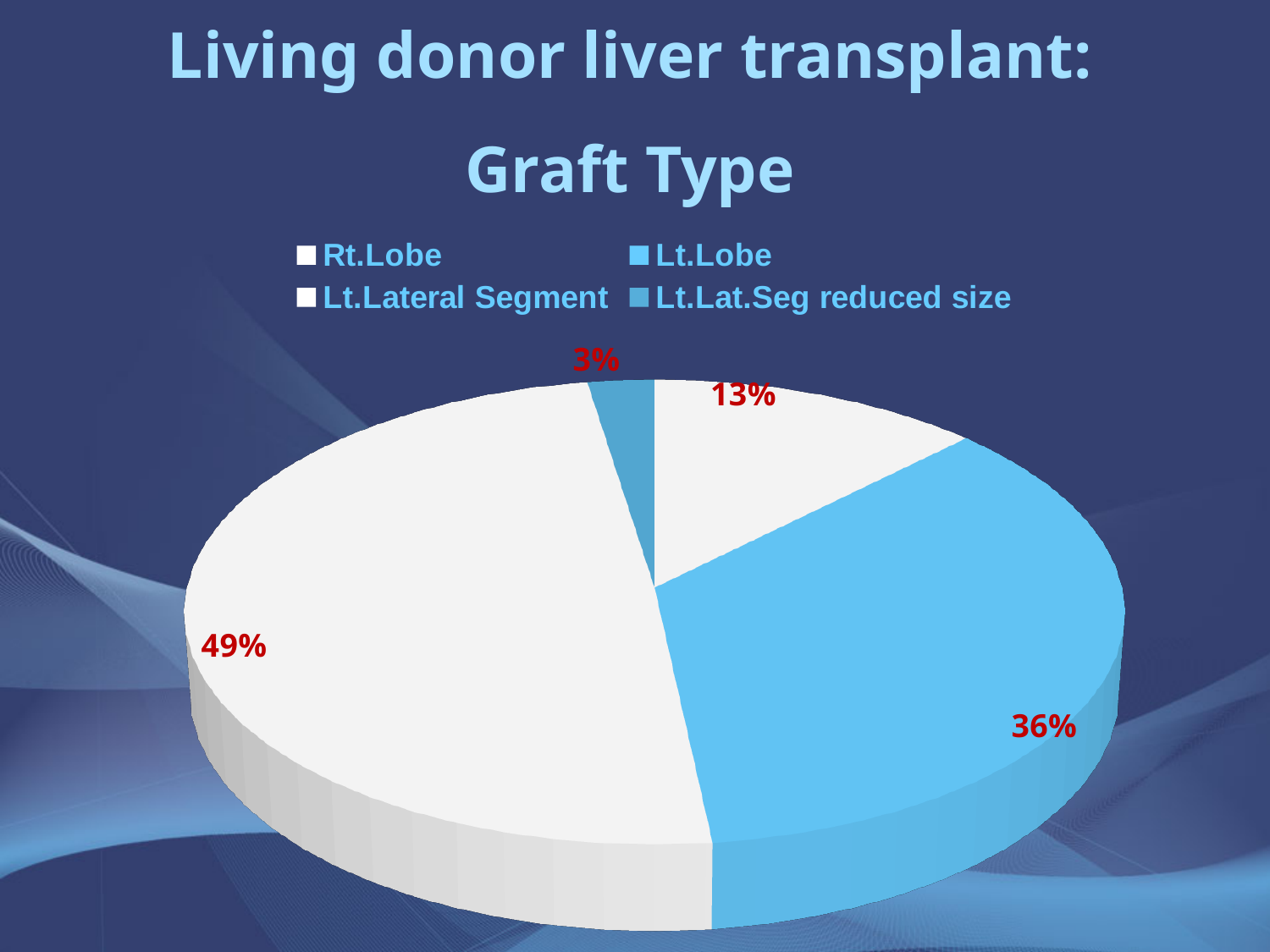
What is the largest percentage shown on the pie chart? 49% How many slices does the pie chart have? 4 What kind of chart is shown on the slide? Pie chart Which is larger, the share for Lt.Lobe or the share for Lt.Lat.Seg reduced size? Lt.Lobe How many percentage points larger is the Lt.Lobe share than the Lt.Lat.Seg reduced size share? 33 percentage points What is the combined share of the Lt.Lobe and Lt.Lat.Seg reduced size slices? 39% How many graft types are listed in the legend? 4 What colour is the Lt.Lobe slice in the pie chart? Light blue What percentage of grafts are Lt.Lat.Seg reduced size? 3% What is the title of the chart on the slide? Living donor liver transplant: Graft Type What percentage of grafts are Lt.Lobe? 36% Which graft type has the smallest share of the pie? Lt.Lat.Seg reduced size